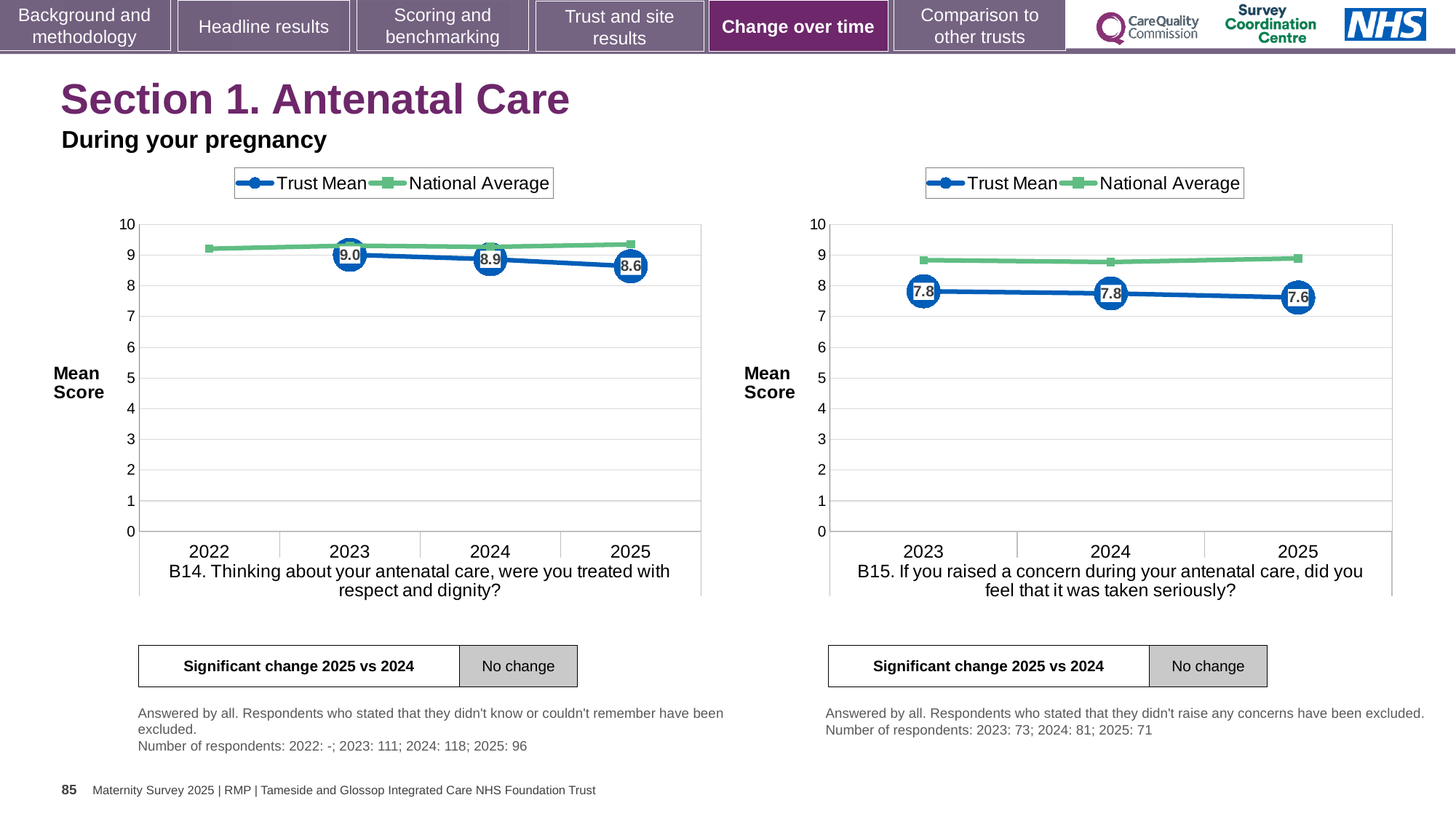
In the B15 chart (right), what is the Trust Mean score for 2024? 7.8 In the B14 chart (left), does the Trust Mean rise or fall from 2023 to 2025? fall In the B14 chart (left), by how much did the Trust Mean fall from 2023 to 2025? 0.4 How many years are shown on the x axis of the B15 chart (right)? 3 What type of chart is the B14 chart (left)? line chart In the B15 chart (right), what is the Trust Mean score for 2025? 7.6 In the B15 chart (right), what is the difference between the Trust Mean in 2024 and in 2025? 0.2 In the B15 chart (right), is the National Average for 2025 greater or less than 8? greater In the B14 chart (left), what is the Trust Mean score for 2025? 8.6 In the B15 chart (right), which is higher in 2025, the Trust Mean or the National Average? National Average How many series does the legend of the B14 chart (left) list? 2 In the B14 chart (left), what is the Trust Mean score for 2023? 9.0